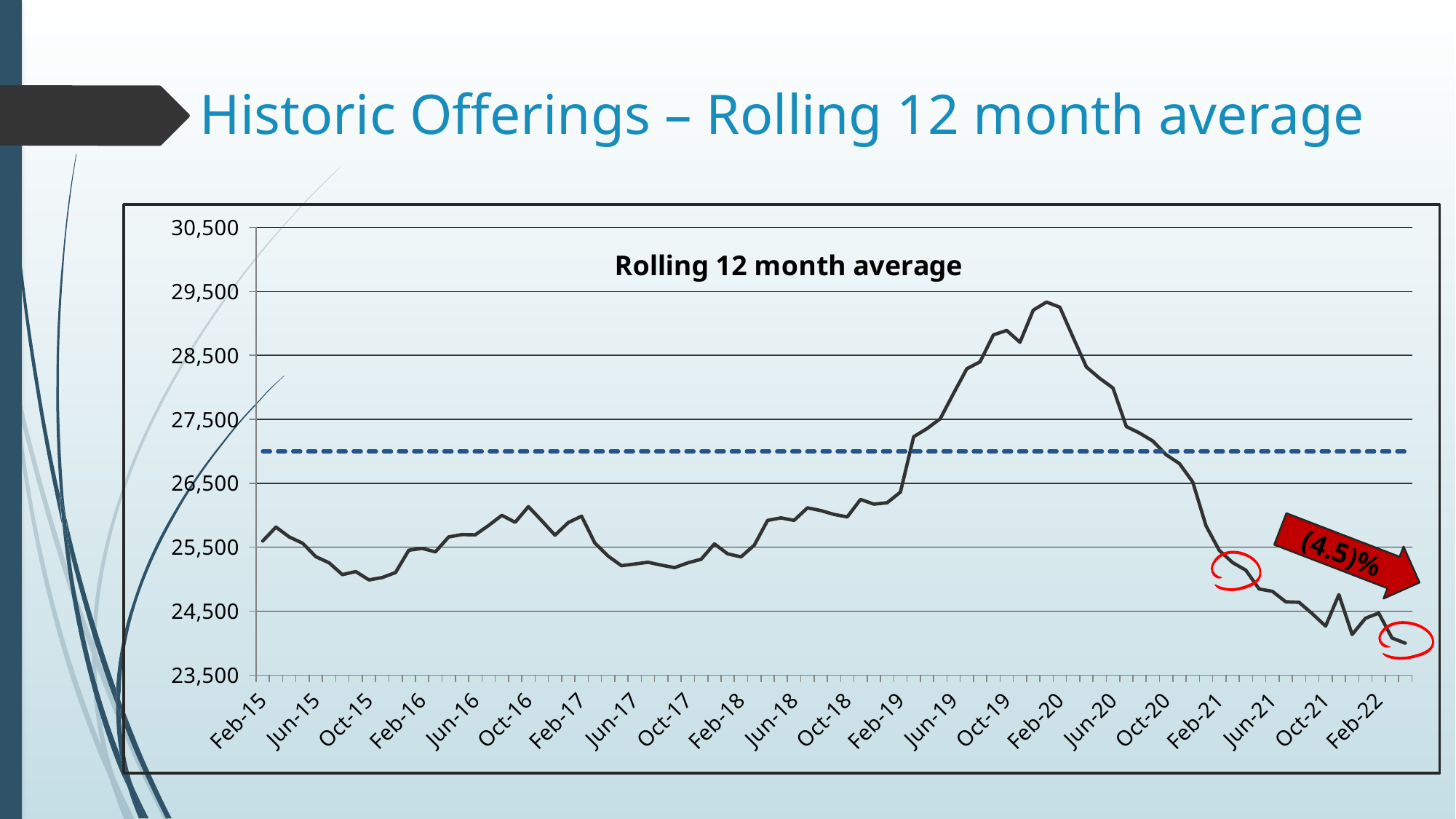
Does the line rise or fall between Feb-20 and Feb-22? fall Is the value of the line at Feb-20 greater or less than 28,500? greater Is the value of the line at Jun-19 greater or less than 27,500? greater Which is larger, the value at Feb-20 or the value at Feb-22? Feb-20 What is the title printed inside the chart? Rolling 12 month average Does the line rise or fall between Feb-19 and Feb-20? rise Is the value of the line at Jun-21 greater or less than 25,500? less What kind of chart is shown on the slide? line chart What percentage is printed on the red arrow in the chart? (4.5)%